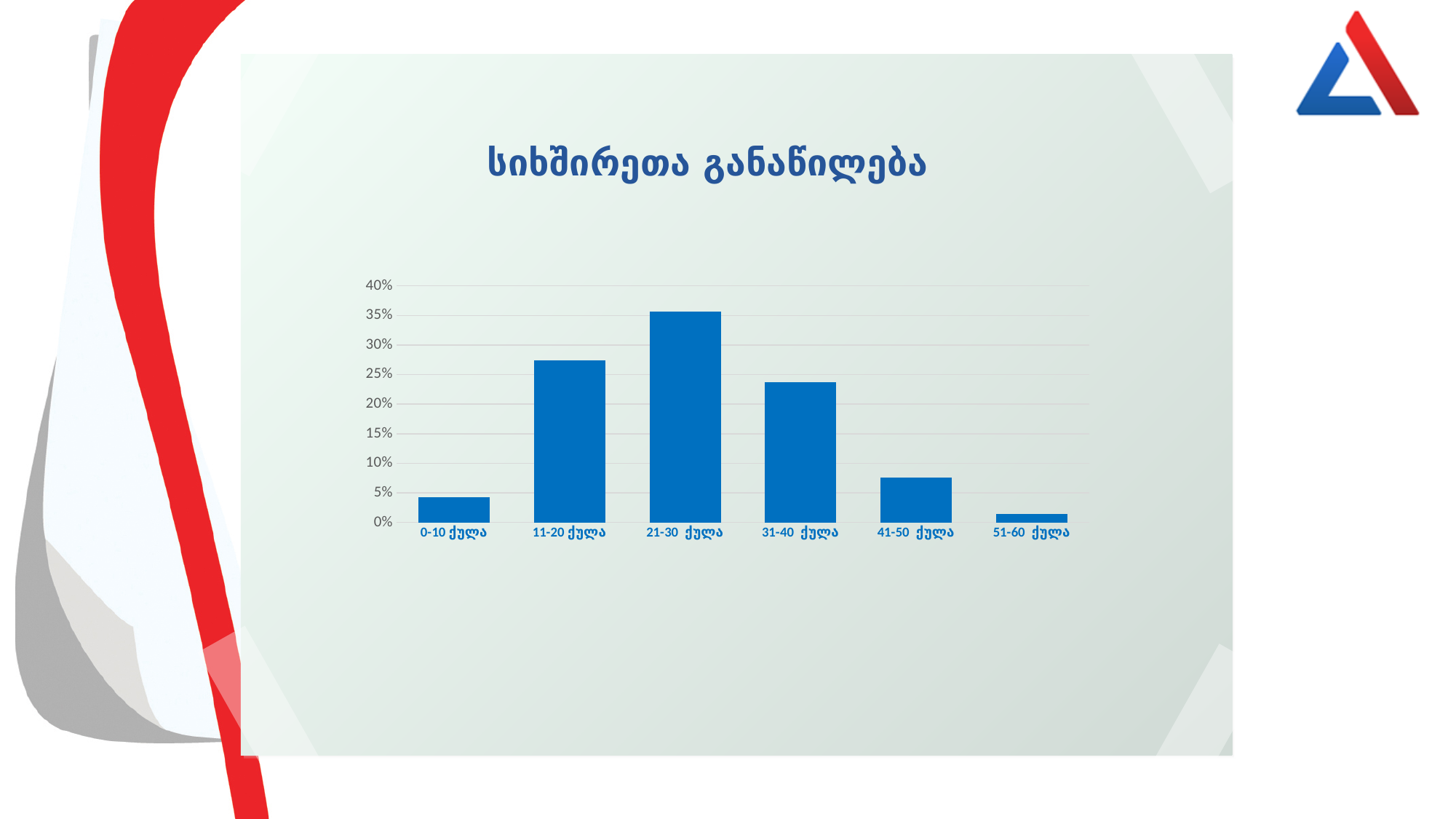
What kind of chart is shown on the slide? bar chart Is the value for 31-40 ქულა greater or less than 20%? greater How many categories are shown on the x axis of the chart? 6 What is the title of the chart? სიხშირეთა განაწილება Is the value for 41-50 ქულა greater or less than 10%? less Which has the larger value, 0-10 ქულა or 41-50 ქულა? 41-50 ქულა Do the values rise or fall along the x axis from 21-30 ქულა to 51-60 ქულა? fall Is the value for 0-10 ქულა greater or less than 5%? less Which category has the highest value in the chart? 21-30 ქულა Which category has the lowest value in the chart? 51-60 ქულა Which has the larger value, 11-20 ქულა or 31-40 ქულა? 11-20 ქულა